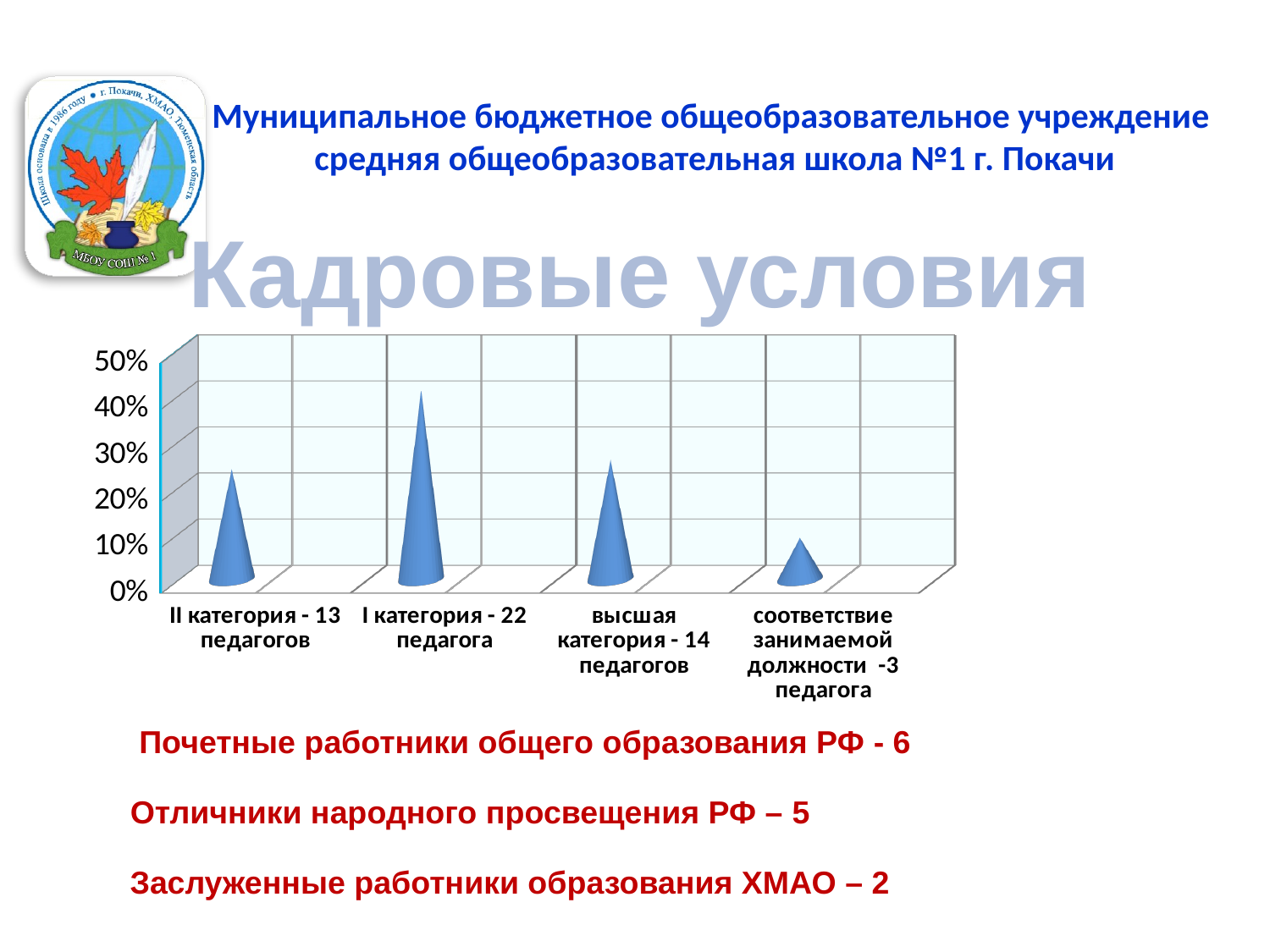
Is the value for 'II категория - 13 педагогов' greater or less than 30%? less Is the value for 'I категория - 22 педагога' greater or less than 30%? greater Which is larger: the value for 'I категория - 22 педагога' or the value for 'II категория - 13 педагогов'? I категория - 22 педагога Which is larger: the value for 'высшая категория - 14 педагогов' or the value for 'соответствие занимаемой должности -3 педагога'? высшая категория - 14 педагогов How many categories are shown on the chart? 4 What kind of chart is shown on the slide? bar chart What is the highest value shown on the chart's vertical axis? 50% Which category has the lowest value on the chart? соответствие занимаемой должности -3 педагога Is the value for 'высшая категория - 14 педагогов' greater or less than 20%? greater Which category has the highest value on the chart? I категория - 22 педагога